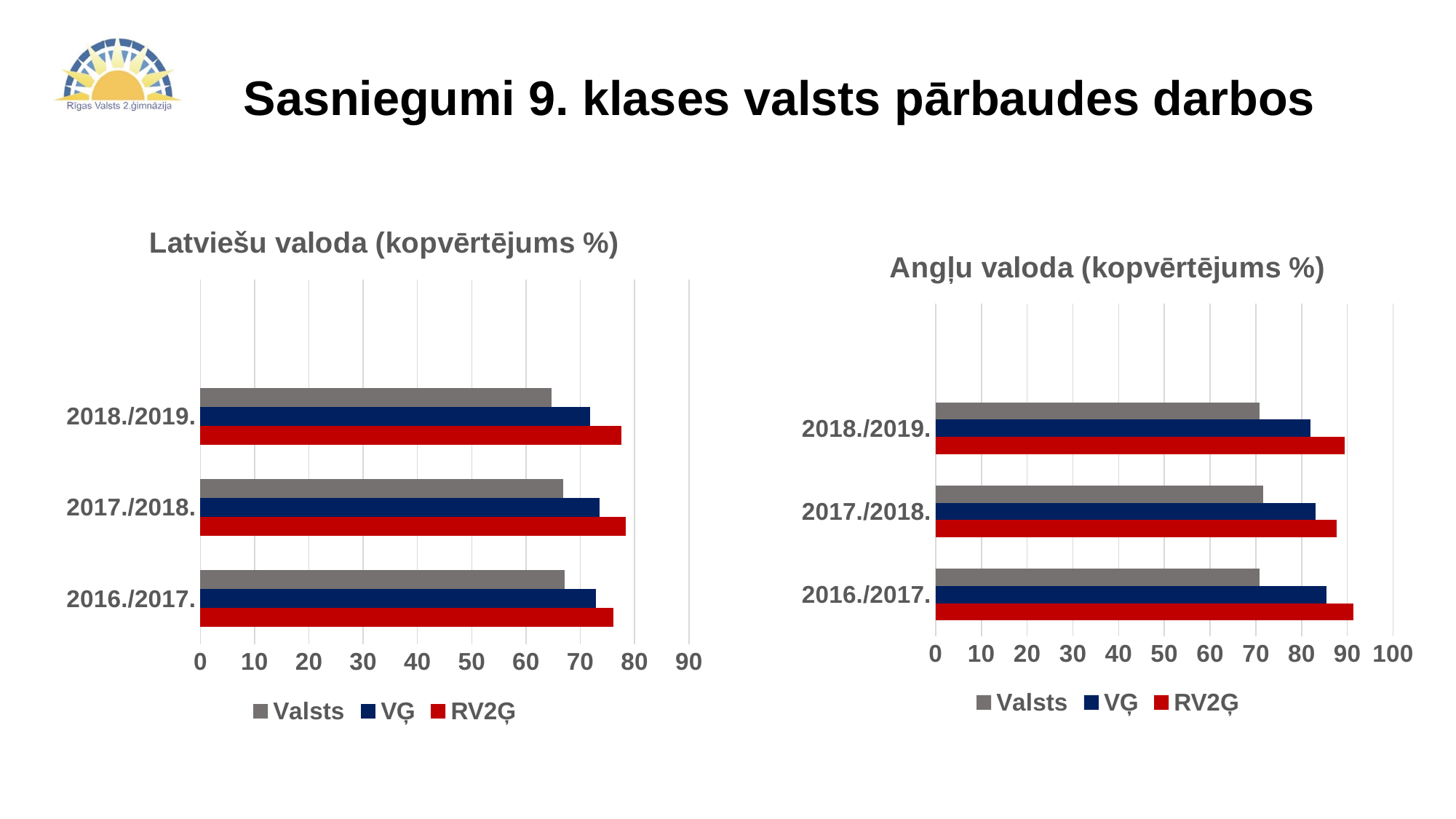
What kind of chart is the 'Latviešu valoda (kopvērtējums %)' chart? bar chart In the 'Latviešu valoda (kopvērtējums %)' chart, which is larger for 2018./2019.: RV2Ģ or Valsts? RV2Ģ In the 'Angļu valoda (kopvērtējums %)' chart, which is larger for 2017./2018.: VĢ or Valsts? VĢ Which series is shown in red on the 'Angļu valoda (kopvērtējums %)' chart? RV2Ģ In the 'Angļu valoda (kopvērtējums %)' chart, is the value for Valsts in 2018./2019. greater or less than 80? less In the 'Latviešu valoda (kopvērtējums %)' chart, which series has the lowest value for 2017./2018.? Valsts In the 'Latviešu valoda (kopvērtējums %)' chart, is the value for RV2Ģ in 2017./2018. greater or less than 70? greater How many series does the legend of the 'Angļu valoda (kopvērtējums %)' chart list? 3 In the 'Angļu valoda (kopvērtējums %)' chart, which series has the highest value for 2016./2017.? RV2Ģ How many school years are shown on the 'Latviešu valoda (kopvērtējums %)' chart? 3 In the 'Latviešu valoda (kopvērtējums %)' chart, is the value for Valsts in 2018./2019. greater or less than 70? less